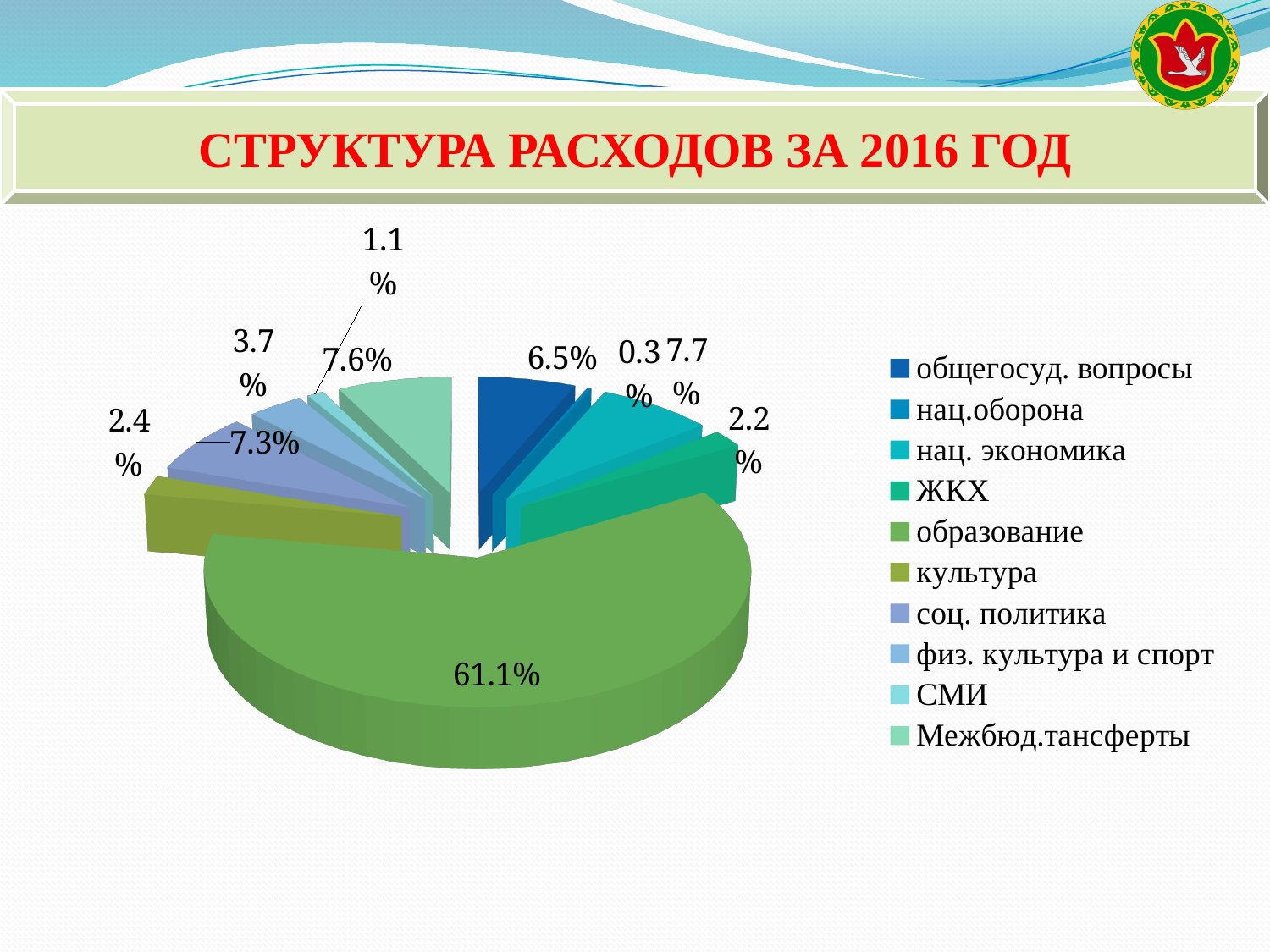
What is the difference between the share for образование and the share for общегосуд. вопросы? 54.6% How many categories does the legend of the pie chart list? 10 Which category has the smallest share of the pie? нац.оборона What share of the pie does образование have? 61.1% What is the value shown for нац.оборона? 0.3% What is the title of the chart on the slide? СТРУКТУРА РАСХОДОВ ЗА 2016 ГОД Which category has the largest share of the pie? образование What is the value shown for культура? 2.4% What is the value shown for общегосуд. вопросы? 6.5% Which is larger, the share for образование or the share for культура? образование What is the value shown for ЖКХ? 2.2% What kind of chart is shown on the slide? pie chart